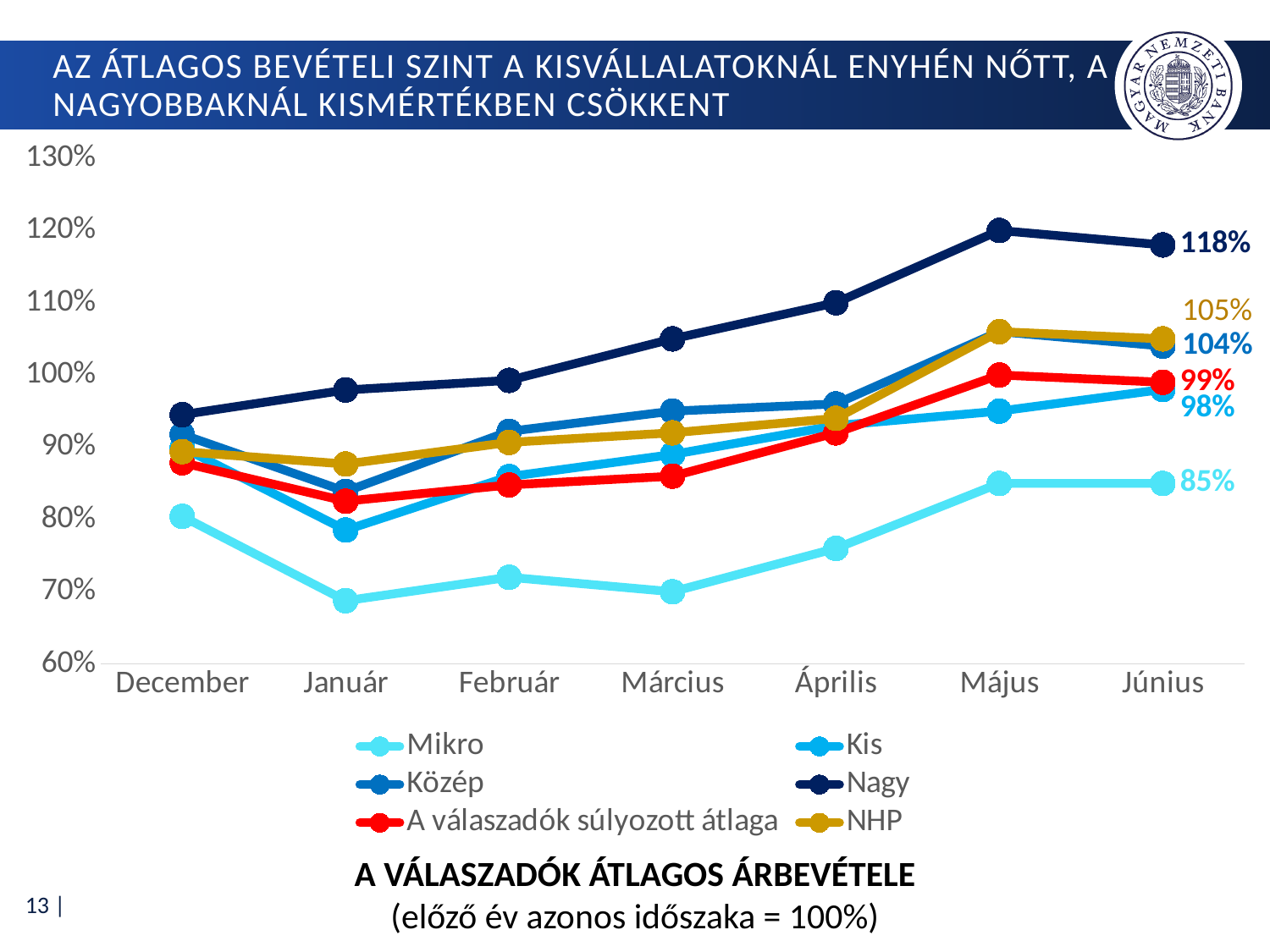
How many series does the legend list? 6 What is the difference between the Nagy and Mikro values in Június? 33% Is the value for Mikro in Január greater or less than 70%? less Which series has the lowest value in Június? Mikro How many months are shown on the x axis? 7 Does the Nagy series rise or fall from December to Május? rise Which series has the highest value in Június? Nagy What type of chart is shown on the slide? line chart What is the value for Nagy in Június? 118% What is the value for Mikro in Június? 85% What is the value for NHP in Június? 105% What is the value for A válaszadók súlyozott átlaga in Június? 99%